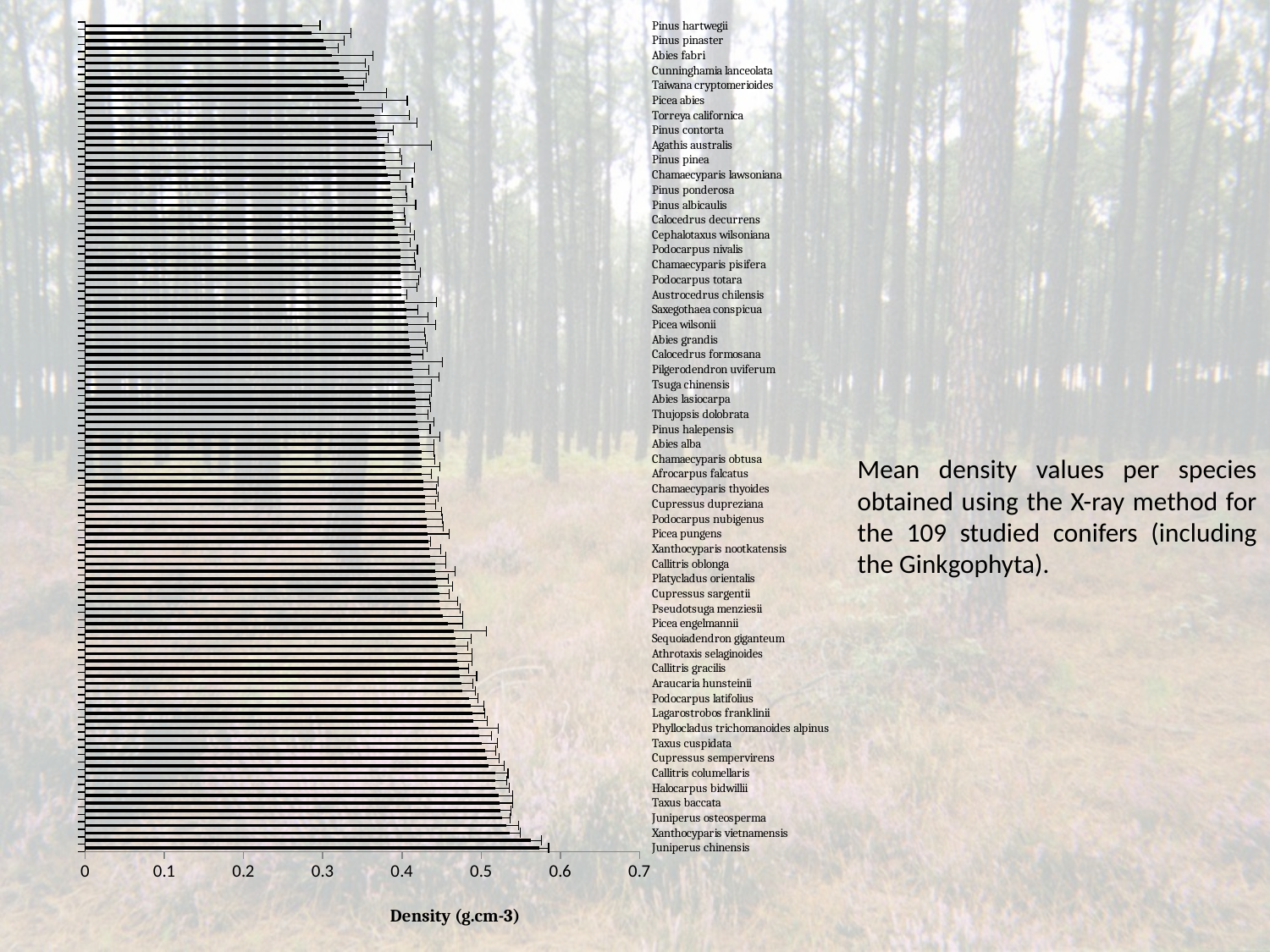
Is the value for Taxus baccata greater or less than 0.5? greater What is the title of the x axis of the chart? Density (g.cm-3) Which has a higher mean density, Juniperus chinensis or Pinus hartwegii? Juniperus chinensis Is the value for Pseudotsuga menziesii greater or less than 0.4? greater Is the value for Juniperus chinensis greater or less than 0.5? greater Do the bar lengths increase or decrease going from the top of the chart to the bottom? increase Which species has the highest mean density in the chart? Juniperus chinensis What kind of chart is shown on the slide? bar chart How many conifer species are plotted in the chart? 109 Which has a higher mean density, Taxus baccata or Picea abies? Taxus baccata